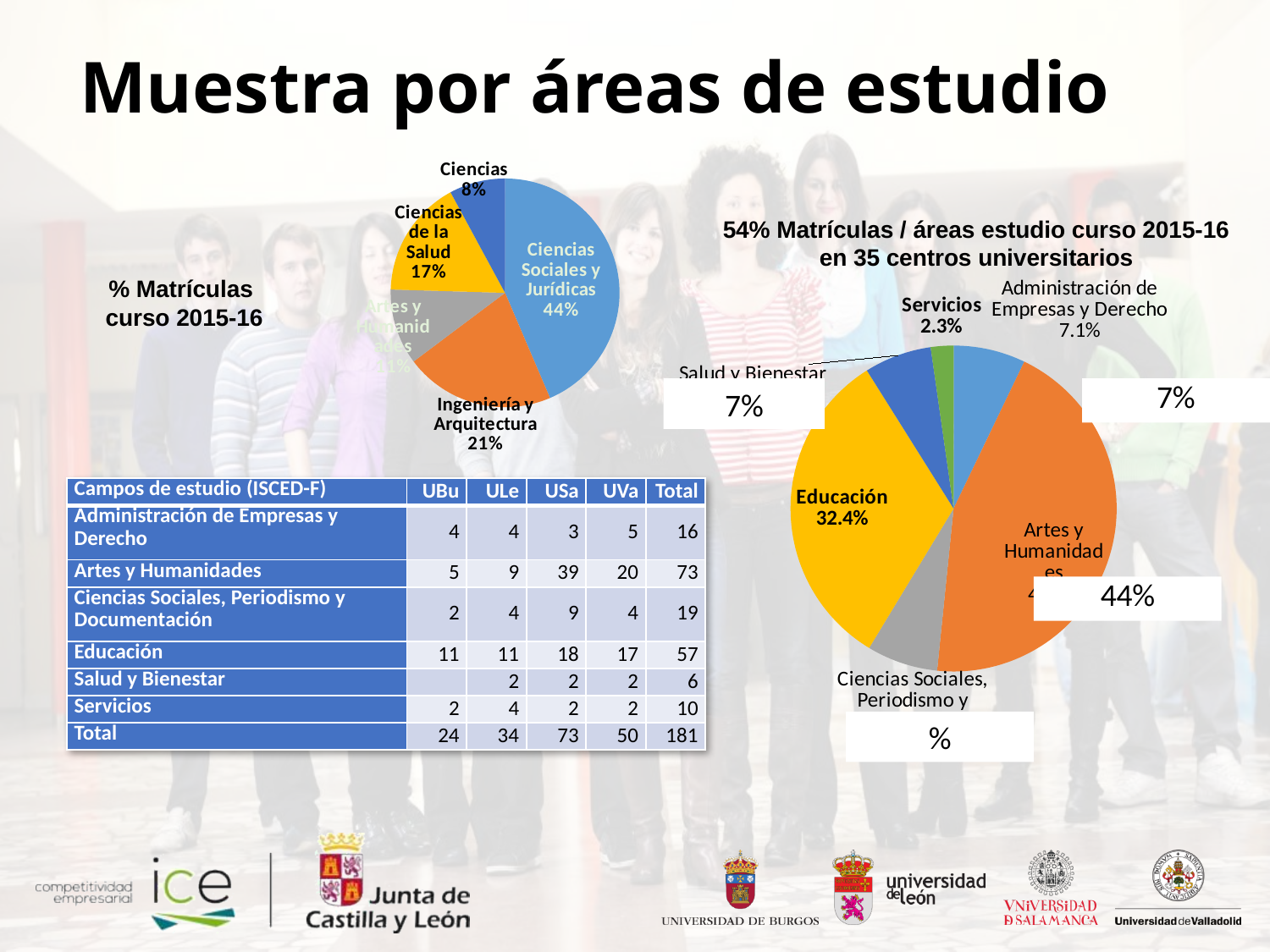
What type of chart is the left chart '% Matrículas curso 2015-16'? Pie chart In the right pie chart '54% Matrículas / áreas estudio curso 2015-16 en 35 centros universitarios', what percentage is shown for Educación? 32.4% In the left pie chart '% Matrículas curso 2015-16', what is the difference in percentage points between Ciencias Sociales y Jurídicas and Ingeniería y Arquitectura? 23 percentage points In the right pie chart '54% Matrículas / áreas estudio curso 2015-16 en 35 centros universitarios', what percentage is shown for Servicios? 2.3% In the right pie chart '54% Matrículas / áreas estudio curso 2015-16 en 35 centros universitarios', which is larger, Educación or Artes y Humanidades? Artes y Humanidades In the left pie chart '% Matrículas curso 2015-16', which area has the smallest share? Ciencias In the right pie chart '54% Matrículas / áreas estudio curso 2015-16 en 35 centros universitarios', which area has the largest share? Artes y Humanidades In the left pie chart '% Matrículas curso 2015-16', what percentage is shown for Ingeniería y Arquitectura? 21% In the right pie chart '54% Matrículas / áreas estudio curso 2015-16 en 35 centros universitarios', what percentage is shown for Administración de Empresas y Derecho? 7.1% In the left pie chart '% Matrículas curso 2015-16', which area has the largest share? Ciencias Sociales y Jurídicas In the left pie chart '% Matrículas curso 2015-16', what percentage is shown for Ciencias de la Salud? 17% In the left pie chart '% Matrículas curso 2015-16', what percentage is shown for Ciencias Sociales y Jurídicas? 44%